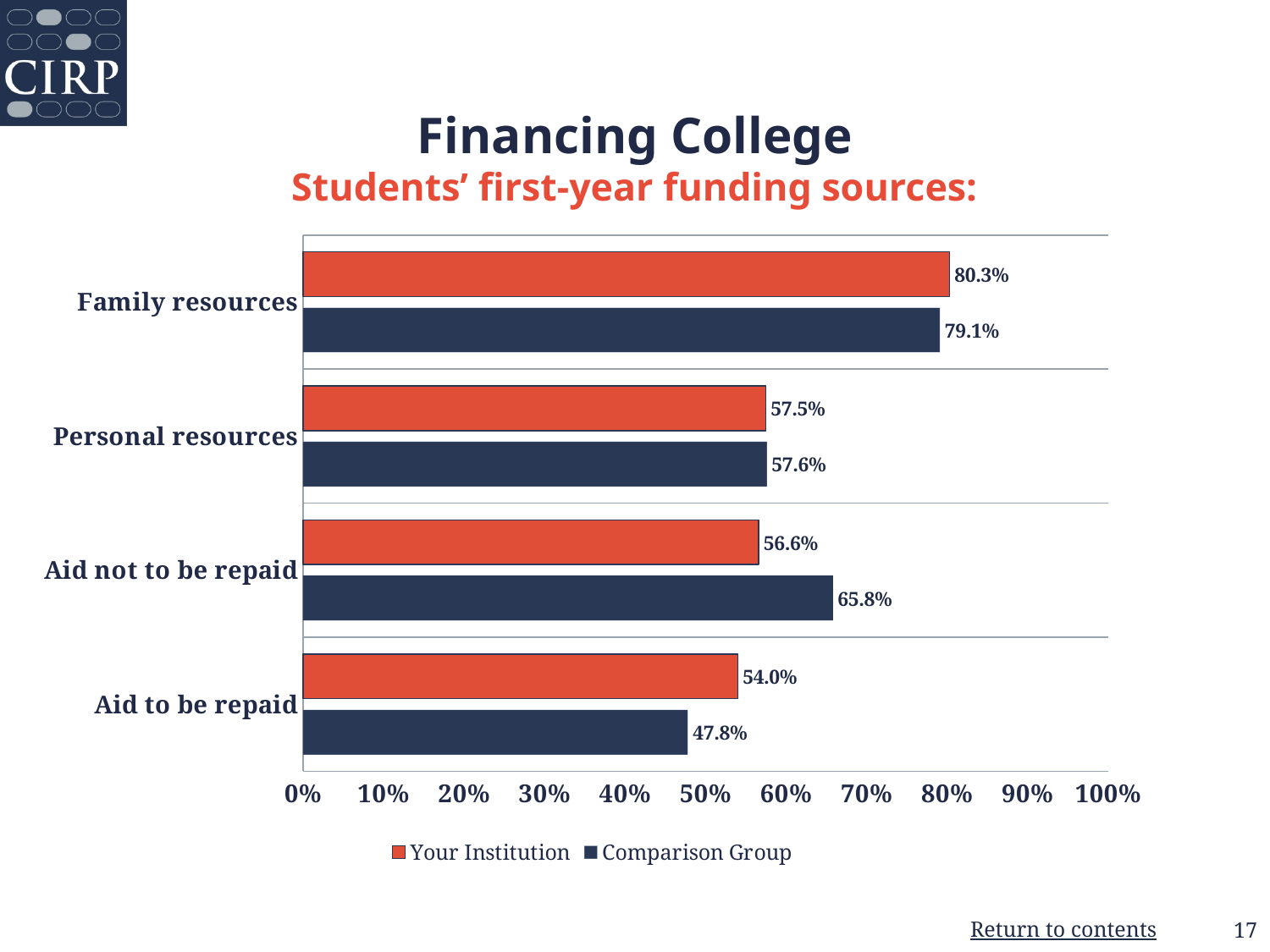
How many series does the legend list? 2 What is the difference between Your Institution and the Comparison Group values for Aid to be repaid? 6.2% Is the value for Family resources for the Comparison Group greater or less than 70%? greater Which category has the highest value for the Comparison Group? Family resources What kind of chart is shown on the slide? Bar chart Which category has the lowest value for Your Institution? Aid to be repaid What is the value for Aid to be repaid for Your Institution? 54.0% How many categories are shown on the chart? 4 For Aid to be repaid, which series has the larger value, Your Institution or Comparison Group? Your Institution What is the value for Aid not to be repaid for the Comparison Group? 65.8% What is the difference between the Comparison Group and Your Institution values for Aid not to be repaid? 9.2% What is the value for Family resources for Your Institution? 80.3%